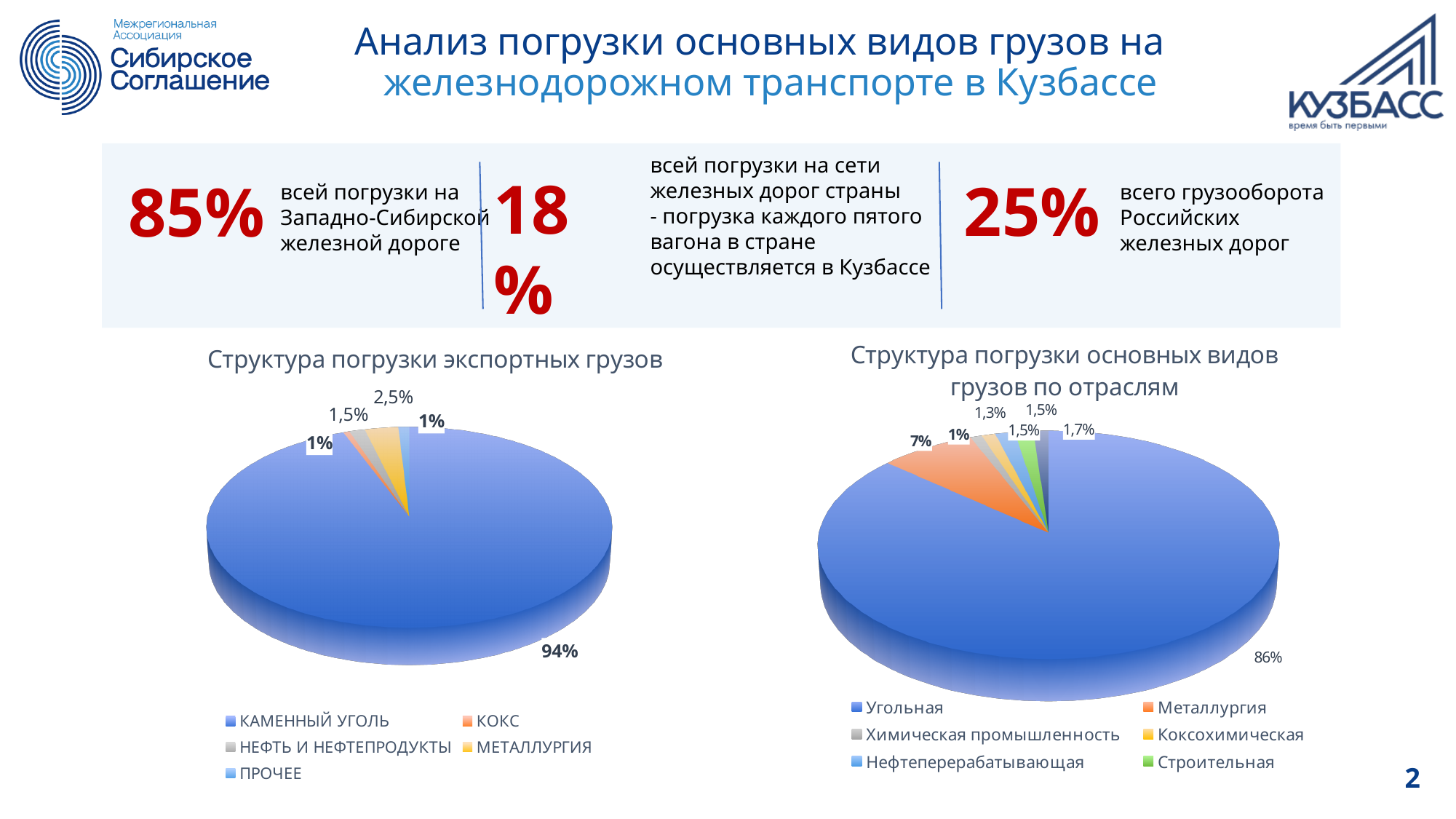
In the chart titled "Структура погрузки экспортных грузов", what share does КАМЕННЫЙ УГОЛЬ have? 94% In the chart titled "Структура погрузки экспортных грузов", how many slices does the pie have? 5 In the chart titled "Структура погрузки основных видов грузов по отраслям", which category has the largest slice? Угольная In the chart titled "Структура погрузки основных видов грузов по отраслям", what share does Угольная have? 86% In the chart titled "Структура погрузки экспортных грузов", what kind of chart is shown? Pie chart In the chart titled "Структура погрузки экспортных грузов", what share does МЕТАЛЛУРГИЯ have? 2,5% In the chart titled "Структура погрузки экспортных грузов", which category has the largest slice? КАМЕННЫЙ УГОЛЬ In the chart titled "Структура погрузки экспортных грузов", how many entries does the legend list? 5 In the chart titled "Структура погрузки основных видов грузов по отраслям", which is larger: the share of Угольная or the share of Металлургия? Угольная What is the title of the pie chart on the left side of the slide? Структура погрузки экспортных грузов In the chart titled "Структура погрузки основных видов грузов по отраслям", what is the difference between the shares of Угольная and Металлургия? 79% In the chart titled "Структура погрузки основных видов грузов по отраслям", what share does Металлургия have? 7%